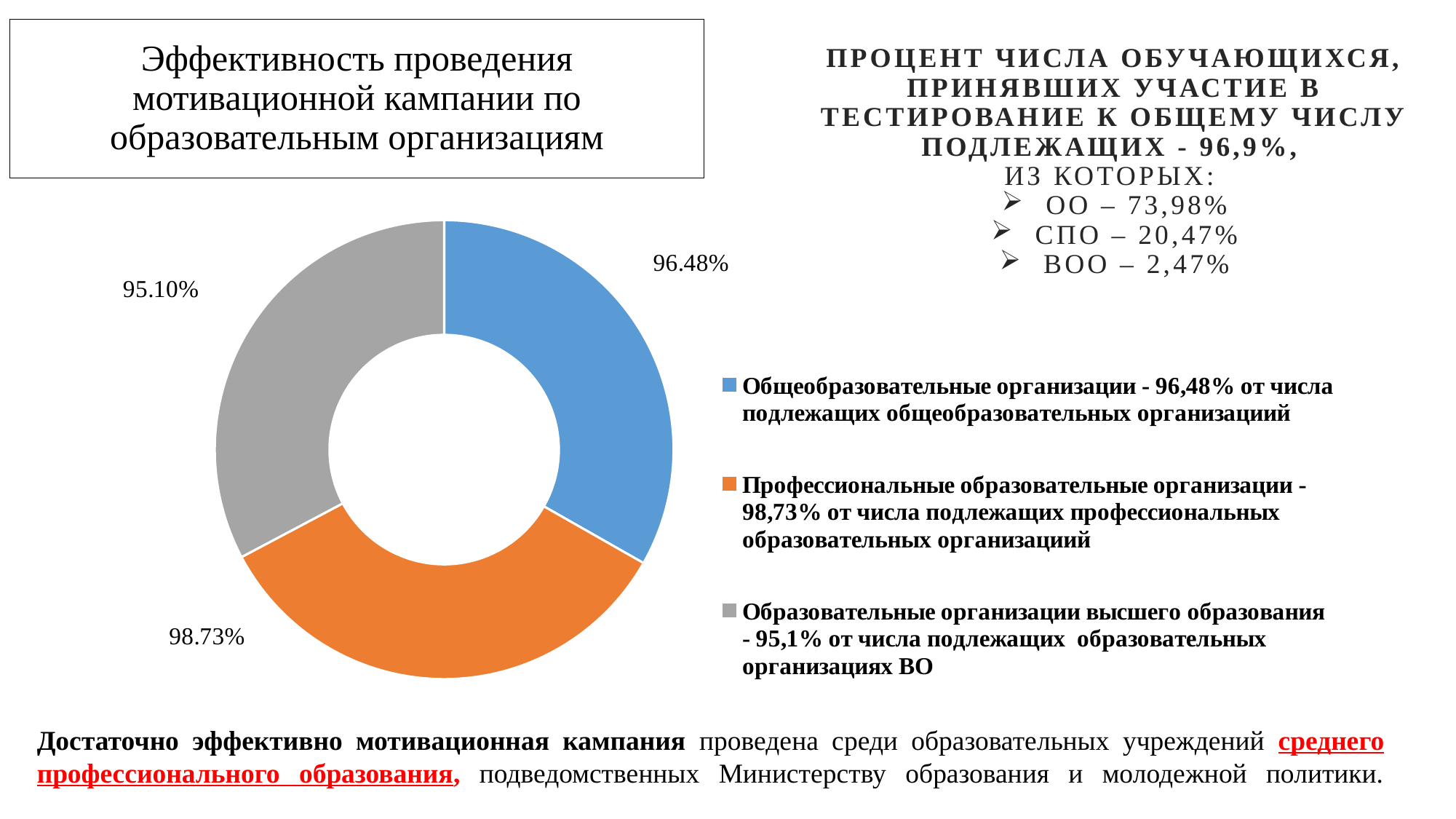
What is the difference between the labelled values for Общеобразовательные организации and Образовательные организации высшего образования? 1.38% Which has a larger labelled value: the blue slice or the grey slice? The blue slice (Общеобразовательные организации) What type of chart is shown on the slide? Doughnut chart What value is labelled on the orange slice (Профессиональные образовательные организации)? 98.73% What value is labelled on the grey slice (Образовательные организации высшего образования)? 95.10% Which category has the highest labelled value in the doughnut chart? Профессиональные образовательные организации How many slices does the doughnut chart have? 3 What value is labelled on the blue slice (Общеобразовательные организации)? 96.48% Which category has the lowest labelled value in the doughnut chart? Образовательные организации высшего образования What is the difference between the labelled values for Профессиональные образовательные организации and Общеобразовательные организации? 2.25% What colour is the slice for Образовательные организации высшего образования? Grey How many entries does the legend of the doughnut chart list? 3